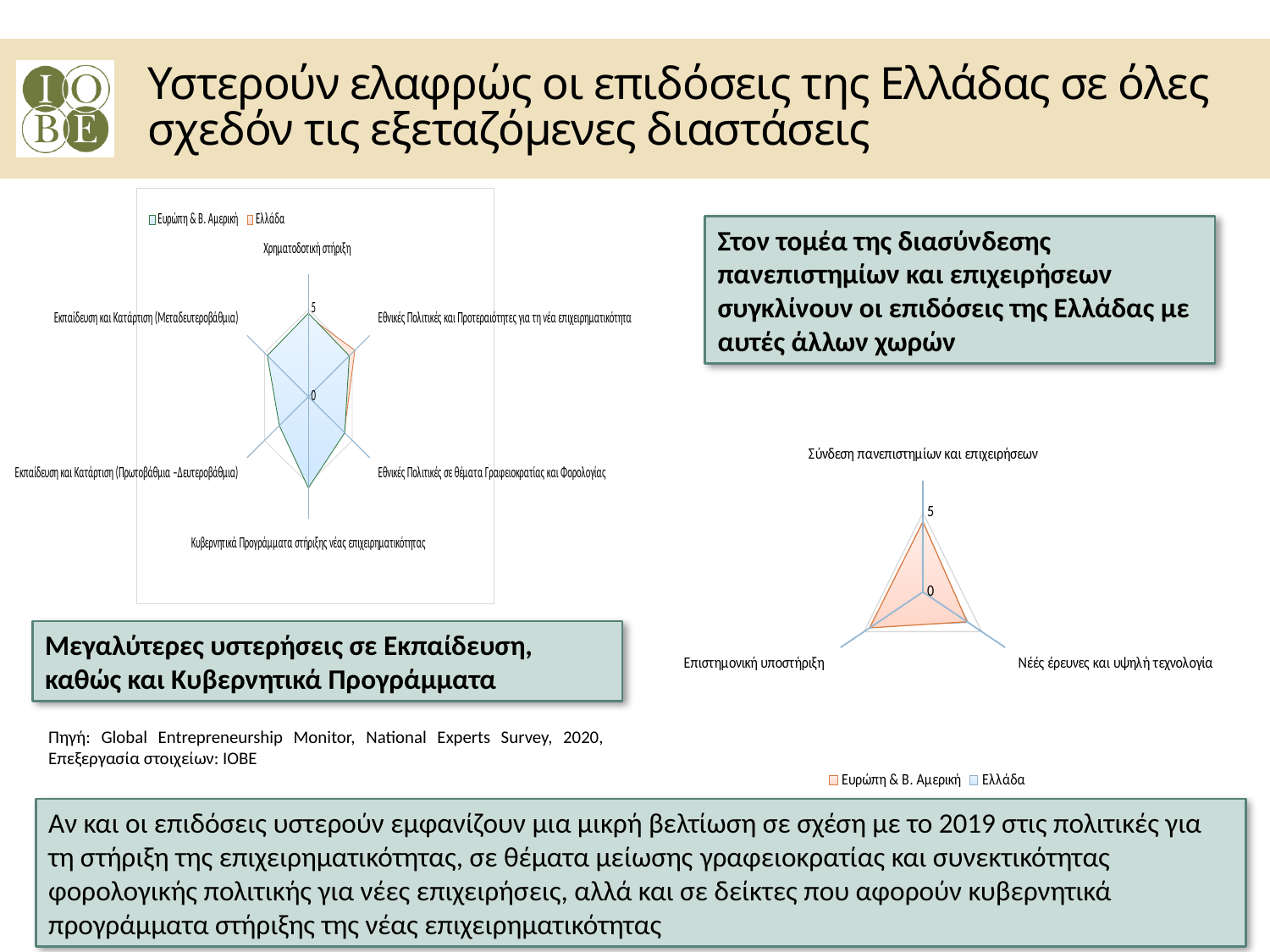
How many categories (axes) does the left radar chart have? 6 What kind of chart is the chart on the left of the slide? Radar chart In the right radar chart, which series is shown in orange? Ευρώπη & Β. Αμερική How many series does the legend of the left radar chart list? 2 How many series does the legend of the right radar chart list? 2 What kind of chart is the chart on the right of the slide (Σύνδεση πανεπιστημίων και επιχειρήσεων)? Radar chart How many categories (axes) does the right radar chart have? 3 In the left radar chart, which series has the larger value for Κυβερνητικά Προγράμματα στήριξης νέας επιχειρηματικότητας, Ευρώπη & Β. Αμερική or Ελλάδα? Ευρώπη & Β. Αμερική In the left radar chart, which series has the larger value for Εκπαίδευση και Κατάρτιση (Πρωτοβάθμια – Δευτεροβάθμια), Ευρώπη & Β. Αμερική or Ελλάδα? Ευρώπη & Β. Αμερική In the right radar chart, is the value of Ελλάδα for Σύνδεση πανεπιστημίων και επιχειρήσεων greater or less than 5? less In the left radar chart, which two series are listed in the legend? Ευρώπη & Β. Αμερική and Ελλάδα